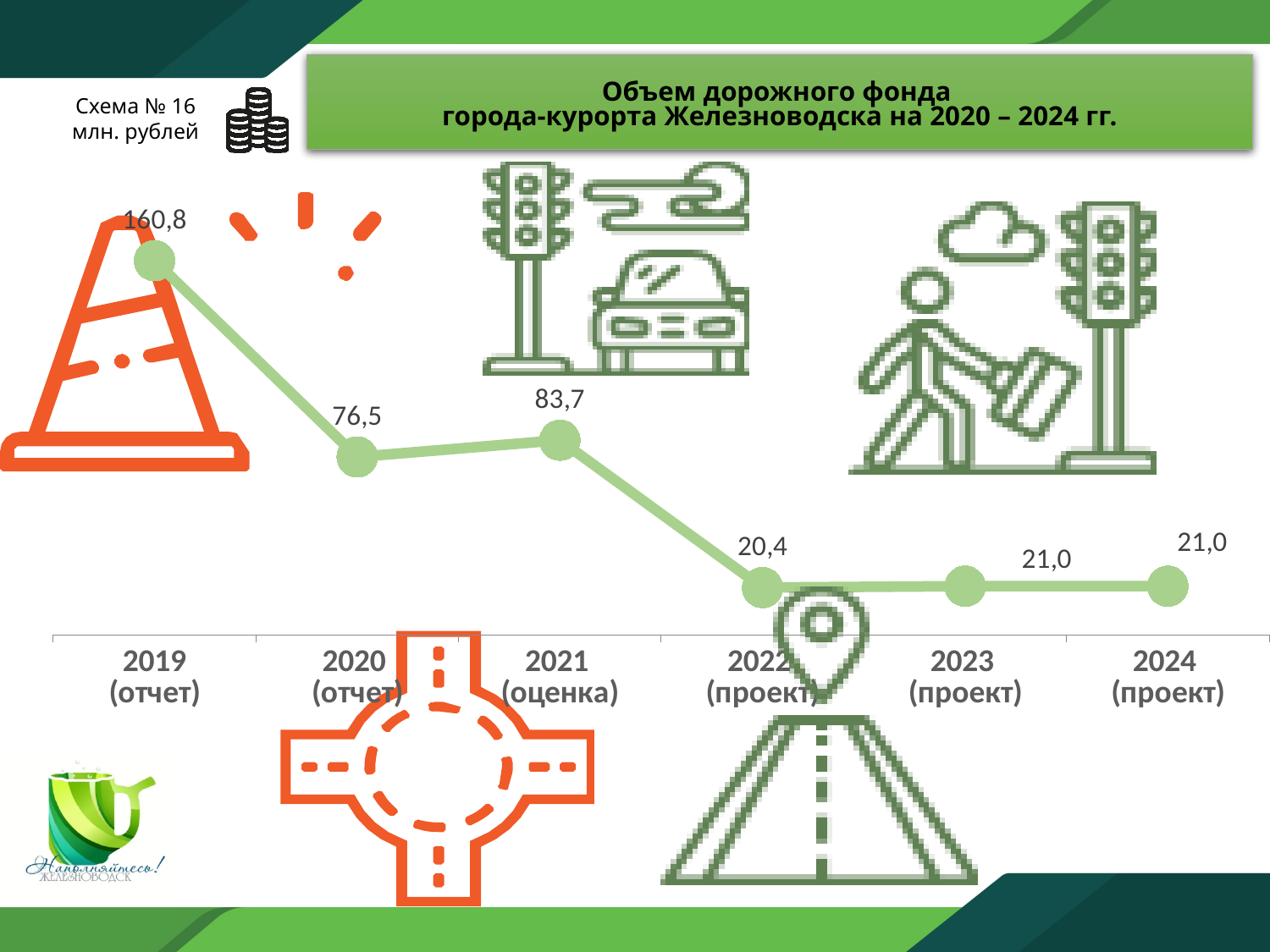
Which is larger, the value for 2020 (отчет) or the value for 2021 (оценка)? 2021 (оценка) In what units are the chart values given? млн. рублей What is the difference between the values for 2019 (отчет) and 2020 (отчет)? 84,3 Which year has the highest value? 2019 (отчет) What is the value for 2021 (оценка)? 83,7 How many data points are plotted on the chart? 6 Which year has the lowest value? 2022 (проект) What is the value for 2022 (проект)? 20,4 What is the value for 2019 (отчет)? 160,8 Do the values generally rise or fall from 2019 to 2024? fall What kind of chart is shown on the slide? line chart What is the difference between the values for 2021 (оценка) and 2022 (проект)? 63,3